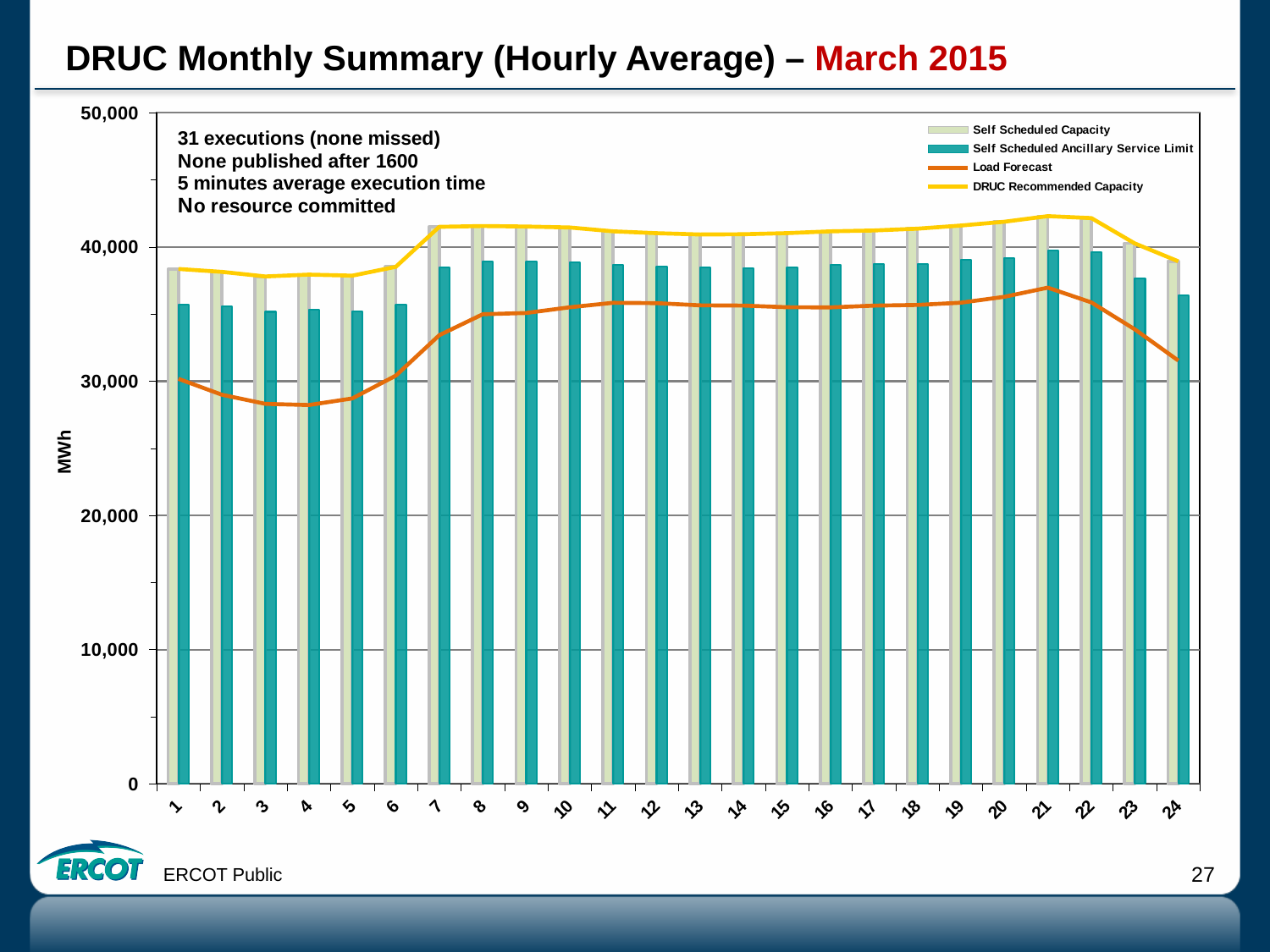
Is the Self Scheduled Ancillary Service Limit value at hour 1 greater or less than 40,000? less Is the Load Forecast value at hour 21 greater or less than 30,000? greater Which is larger, the Self Scheduled Capacity at hour 7 or at hour 1? hour 7 What unit is shown on the y axis label? MWh Is the Load Forecast value at hour 3 greater or less than 30,000? less Does the Load Forecast rise or fall from hour 3 to hour 11? rise How many hours (categories) are shown along the x axis? 24 Does the Load Forecast rise or fall from hour 21 to hour 24? fall What kind of chart is this? Bar chart with line series How many series does the legend list? 4 At which hour does the Load Forecast line reach its highest value? 21